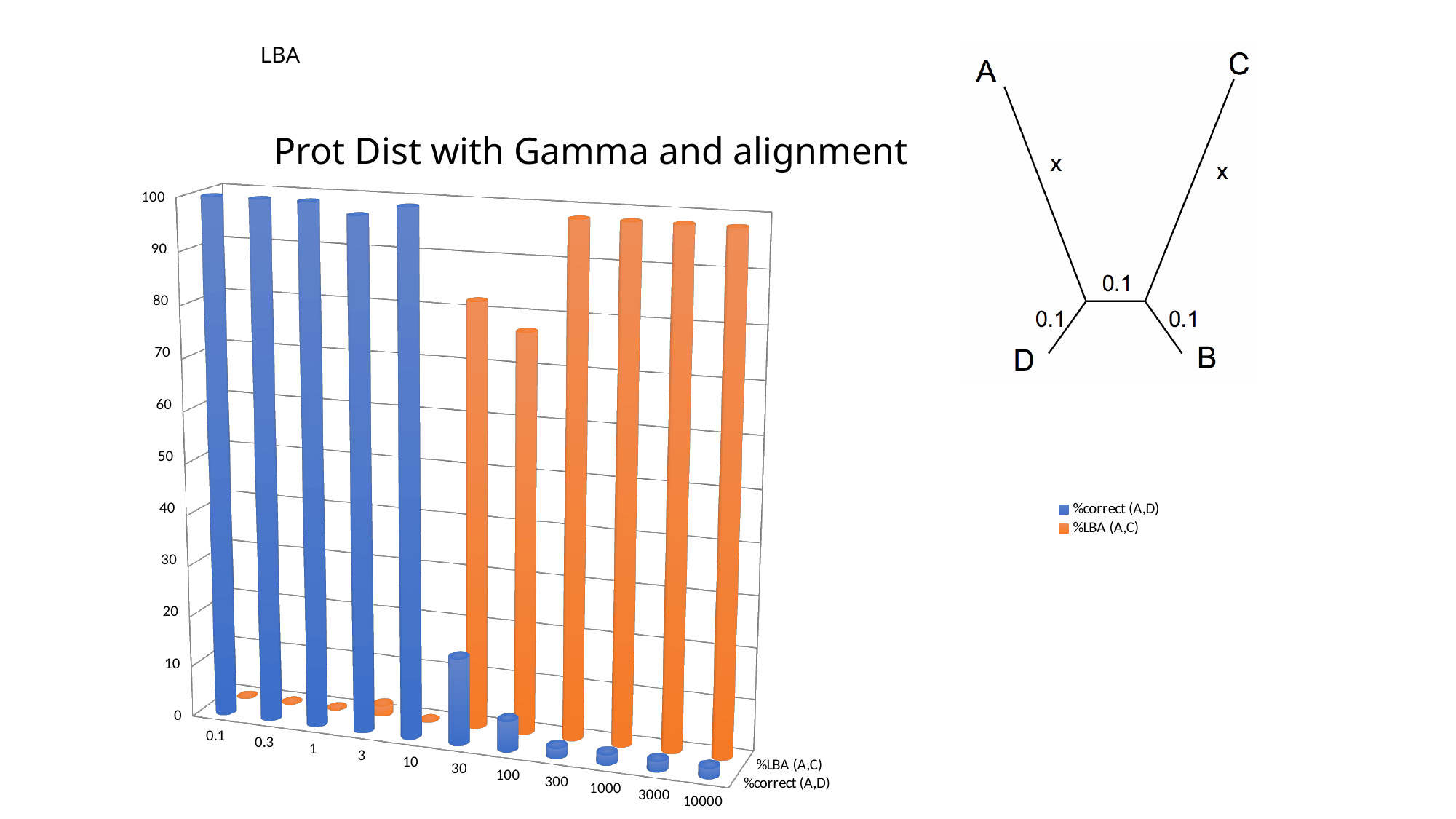
At category 30, which series has the larger value, %correct (A,D) or %LBA (A,C)? %LBA (A,C) How many categories are shown along the x axis of the chart? 11 What kind of chart is shown on the slide? bar chart How many series does the chart's legend list? 2 Is the value of %LBA (A,C) at 0.1 greater or less than 10? less Is the value of %LBA (A,C) at 30 greater or less than 50? greater Is the value of %LBA (A,C) at 10000 greater or less than 80? greater Does the %correct (A,D) series generally rise or fall as the x-axis values increase? fall Which colour represents the %LBA (A,C) series in the chart? orange What is the title of the chart? Prot Dist with Gamma and alignment